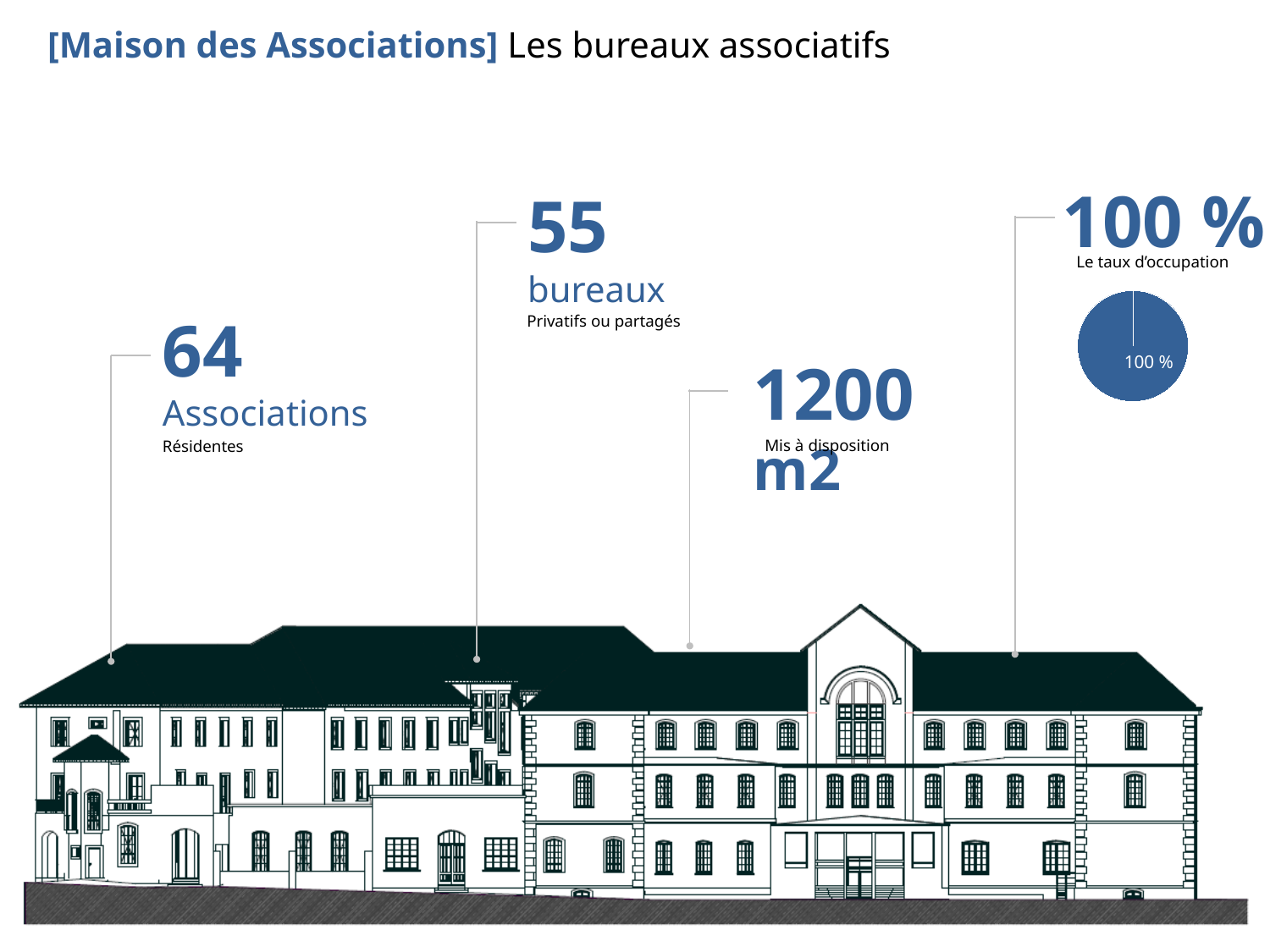
How many slices does the pie chart contain? 1 What value is printed on the slice of the pie chart? 100 % What share of the pie does the single slice represent? 100 % What is the heading written above the pie chart? Le taux d'occupation What kind of chart is shown under "Le taux d'occupation"? pie chart What colour is the pie chart's slice? blue